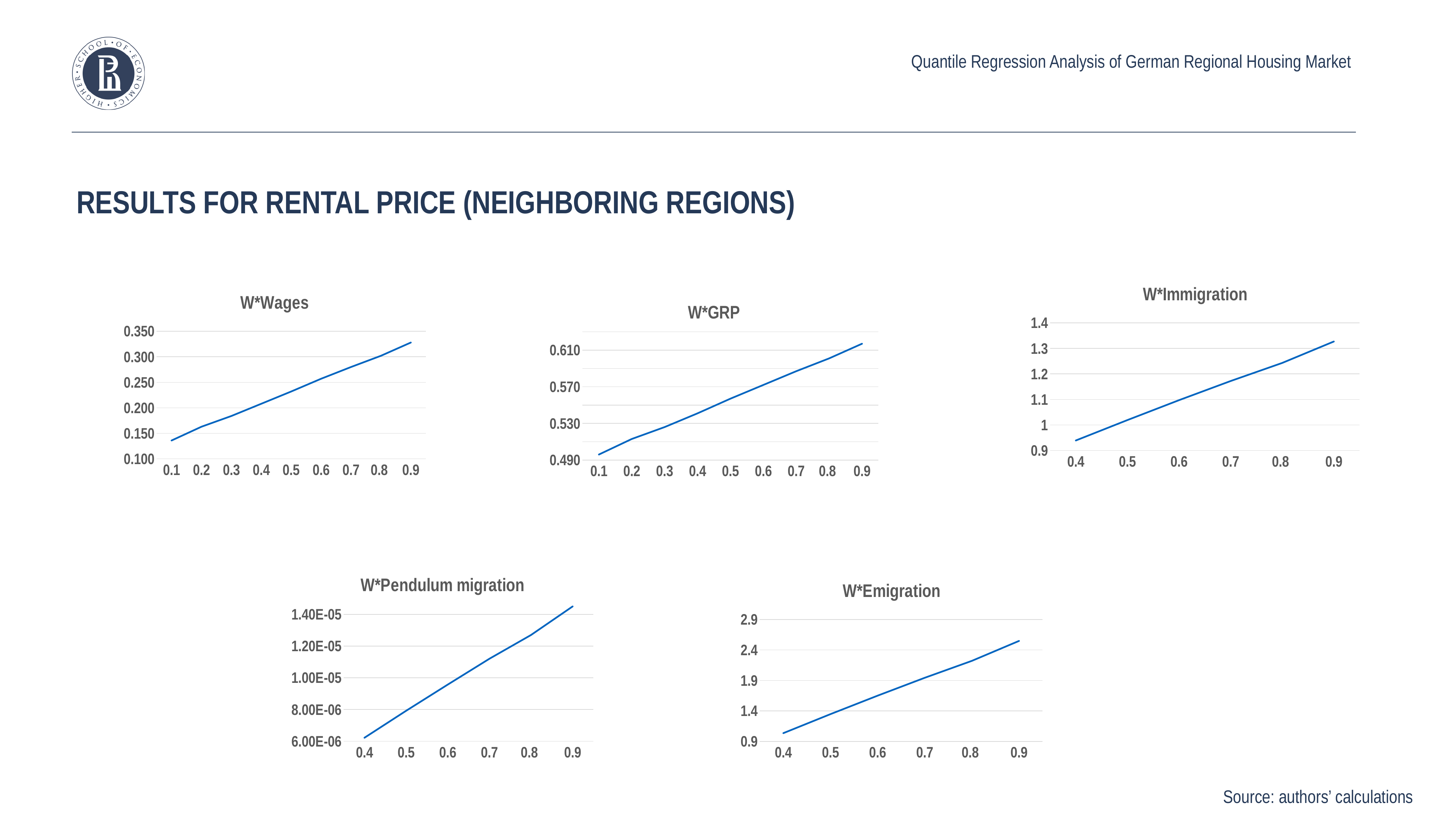
What kind of chart is the W*Wages chart? line chart In the W*Wages chart, do the values rise or fall as the quantile increases from 0.1 to 0.9? rise In the W*Immigration chart, at which quantile is the value highest? 0.9 In the W*Pendulum migration chart, is the value at 0.4 greater or less than 8.00E-06? less In the W*Immigration chart, is the value at 0.4 greater or less than 1? less In the W*Wages chart, is the value at 0.9 greater or less than 0.300? greater How many charts are shown on the slide? 5 In the W*Emigration chart, at which quantile is the value lowest? 0.4 How many points are plotted on the x axis of the W*GRP chart? 9 How many points are plotted on the x axis of the W*Pendulum migration chart? 6